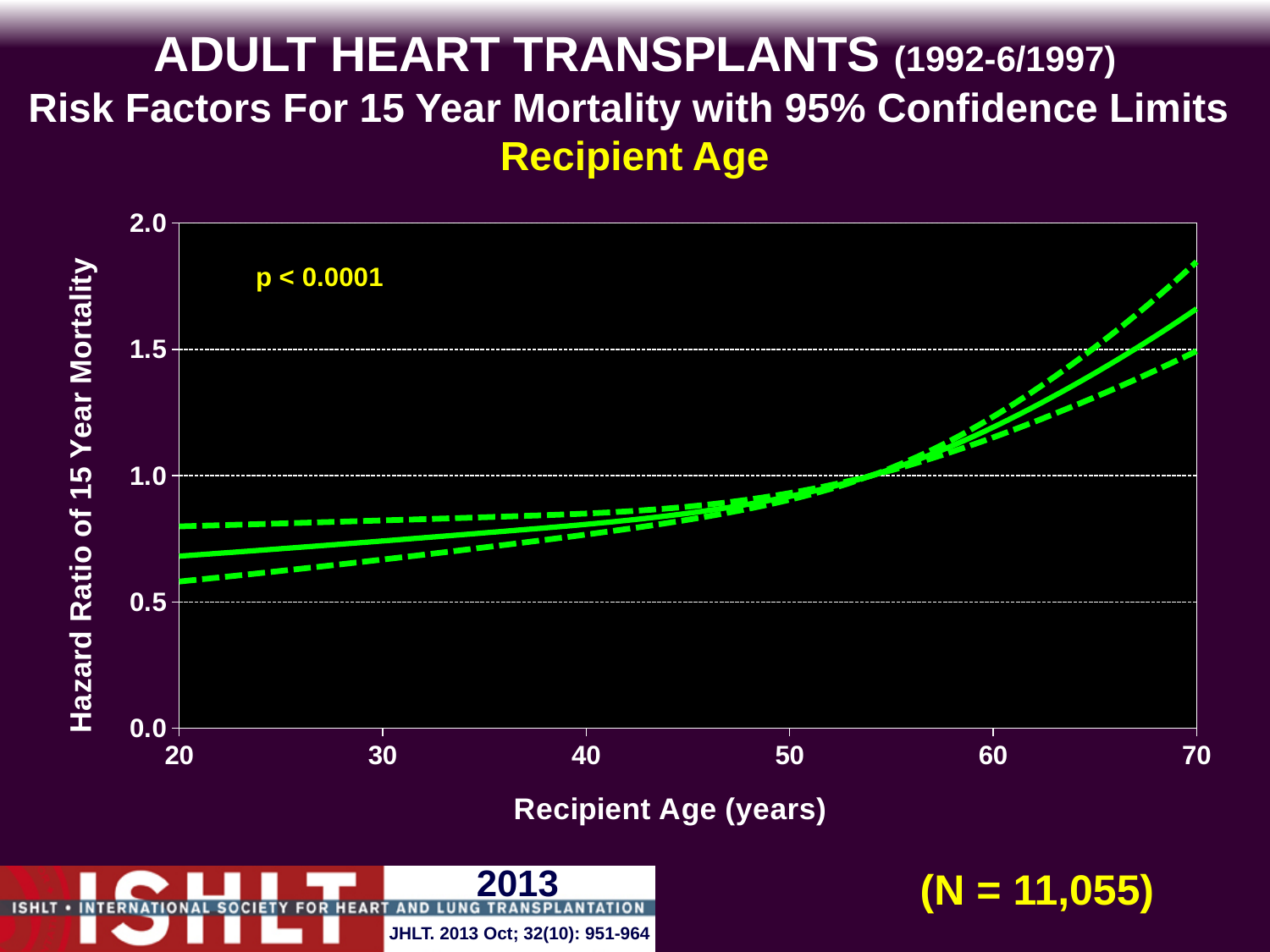
Is the hazard ratio (solid line) higher at a recipient age of 70 years or at 20 years? 70 years Is the hazard ratio (solid line) at a recipient age of 60 years greater or less than 1.0? greater How many lines are plotted on the chart? 3 Does the hazard ratio of 15 year mortality rise or fall as recipient age increases from 20 to 70 years? rise What kind of chart is shown on the slide? line chart What is the title of the y axis of the chart? Hazard Ratio of 15 Year Mortality Is the lower confidence limit (lower dashed line) at a recipient age of 20 years greater or less than 0.5? greater Is the upper confidence limit (upper dashed line) at a recipient age of 20 years greater or less than 1.0? less What p-value is printed on the chart? p < 0.0001